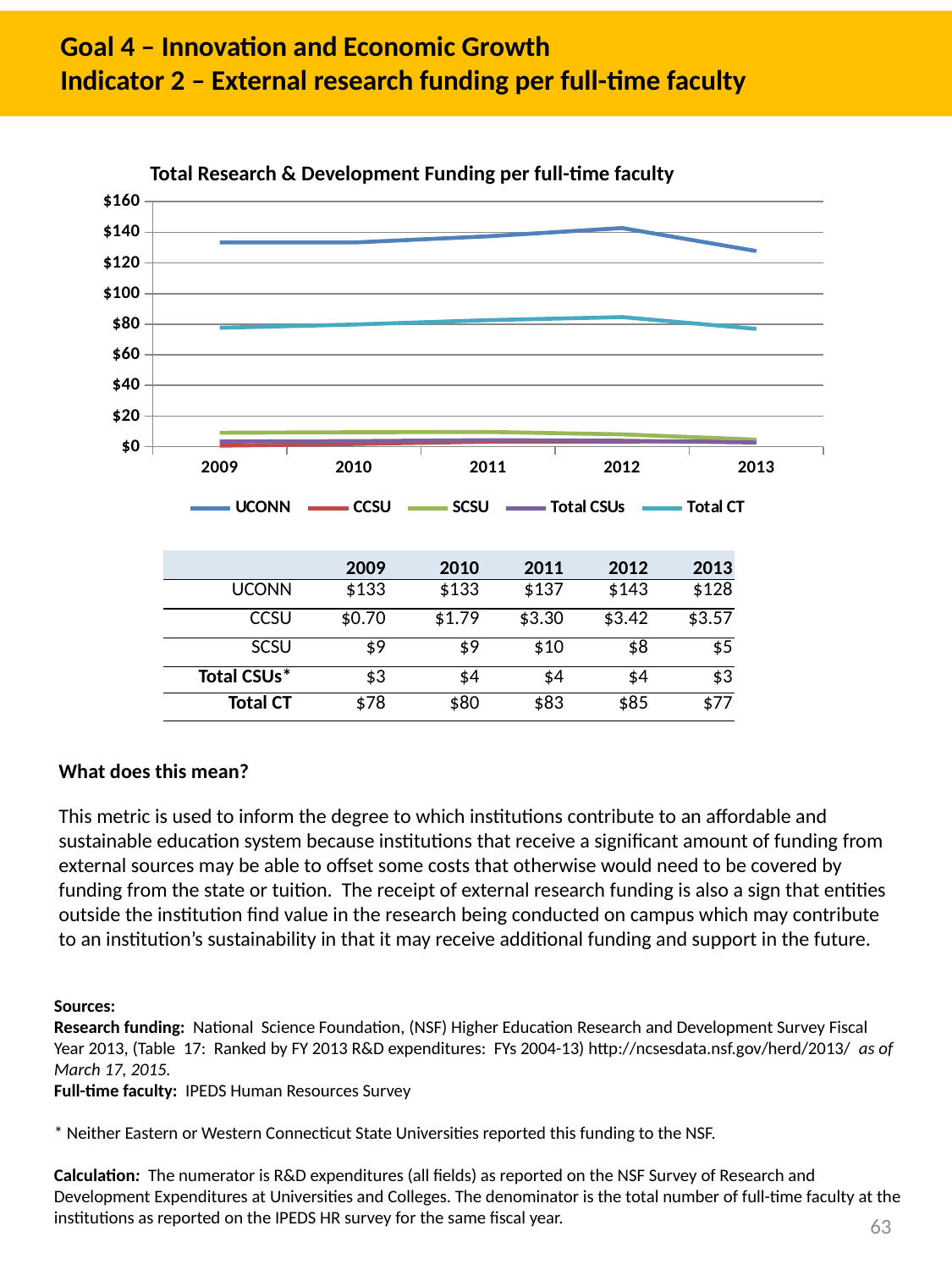
How many years are plotted along the x axis of the chart? 5 What is the value for SCSU in 2011? $10 How many series does the chart's legend list? 5 What is the value for Total CT in 2013? $77 What is the value for UCONN in 2012? $143 What is the difference between the UCONN values for 2012 and 2013? $15 In which year is the UCONN value highest? 2012 In which year is the Total CT value lowest? 2013 Is the value for UCONN in 2013 greater or less than $120? greater What is the title of the chart? Total Research & Development Funding per full-time faculty What kind of chart is shown on the slide? Line chart Which year has the larger Total CT value, 2010 or 2011? 2011